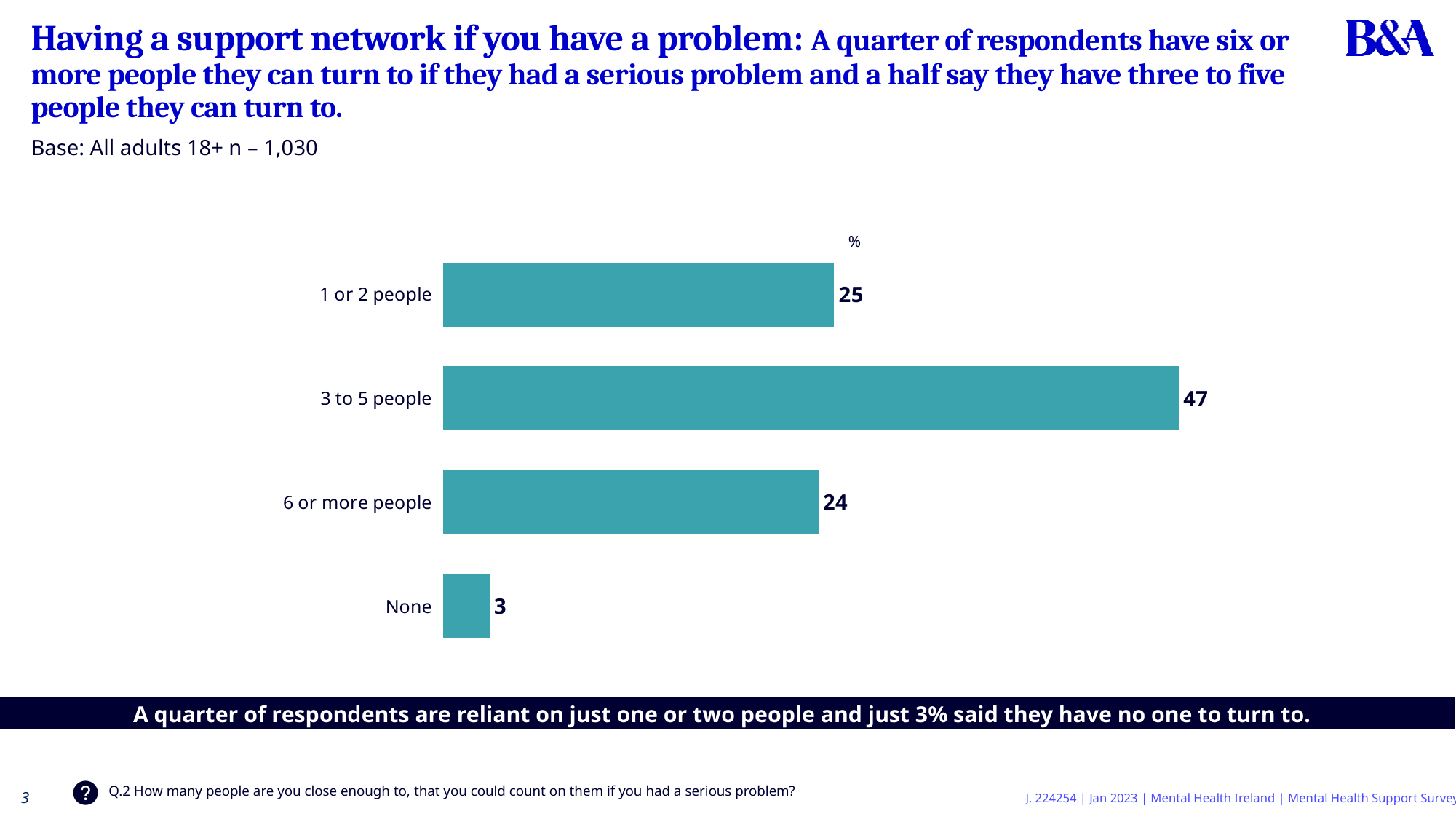
Which category has the highest value? 3 to 5 people How many categories are shown in the chart? 4 Which category has the lowest value? None What is the difference between the values for '3 to 5 people' and '1 or 2 people'? 22 What is the value for 'None'? 3 Which is larger, the value for '3 to 5 people' or the value for '6 or more people'? 3 to 5 people What unit is indicated above the bars in the chart? % What is the value for '3 to 5 people'? 47 What is the value for '1 or 2 people'? 25 What is the difference between the values for '6 or more people' and 'None'? 21 What is the value for '6 or more people'? 24 What kind of chart is shown on the slide? Bar chart